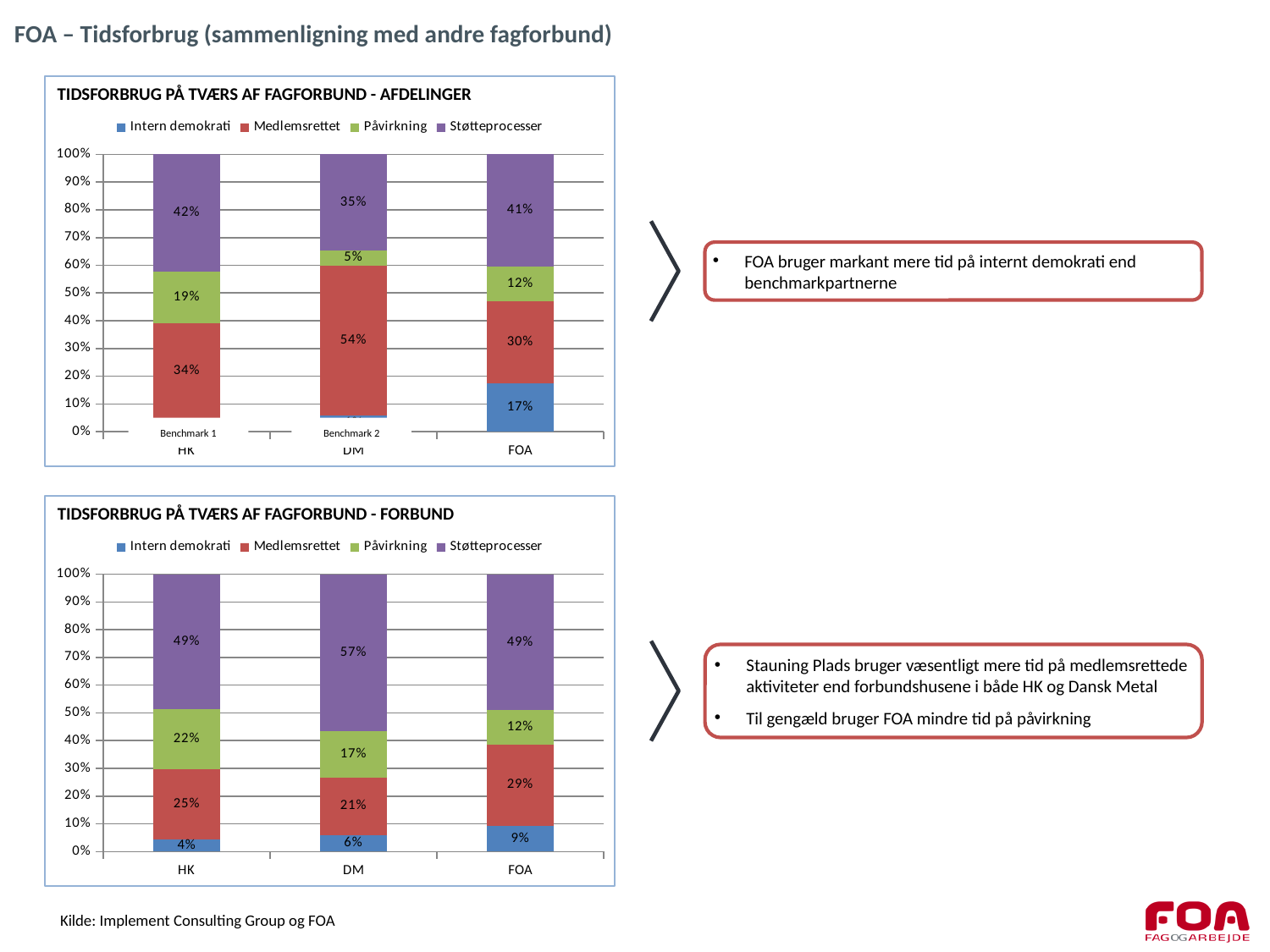
In the top chart (AFDELINGER), which category has the lowest Påvirkning share? DM In the top chart (AFDELINGER), which is larger: the Medlemsrettet share for HK or for FOA? HK In the top chart (AFDELINGER), what is the Medlemsrettet share for DM? 54% In the top chart (AFDELINGER), what is the Intern demokrati share for FOA? 17% What kind of chart is the bottom chart (FORBUND)? Stacked bar chart In the bottom chart (FORBUND), which category has the highest Støtteprocesser share? DM How many series does the legend of the bottom chart (FORBUND) list? 4 In the bottom chart (FORBUND), what is the difference between the Medlemsrettet shares of FOA and DM? 8% In the top chart (AFDELINGER), what is the Støtteprocesser share for HK? 42% In the bottom chart (FORBUND), what is the Påvirkning share for DM? 17% How many categories are shown on the x axis of the top chart (AFDELINGER)? 3 In the bottom chart (FORBUND), what is the Intern demokrati share for HK? 4%